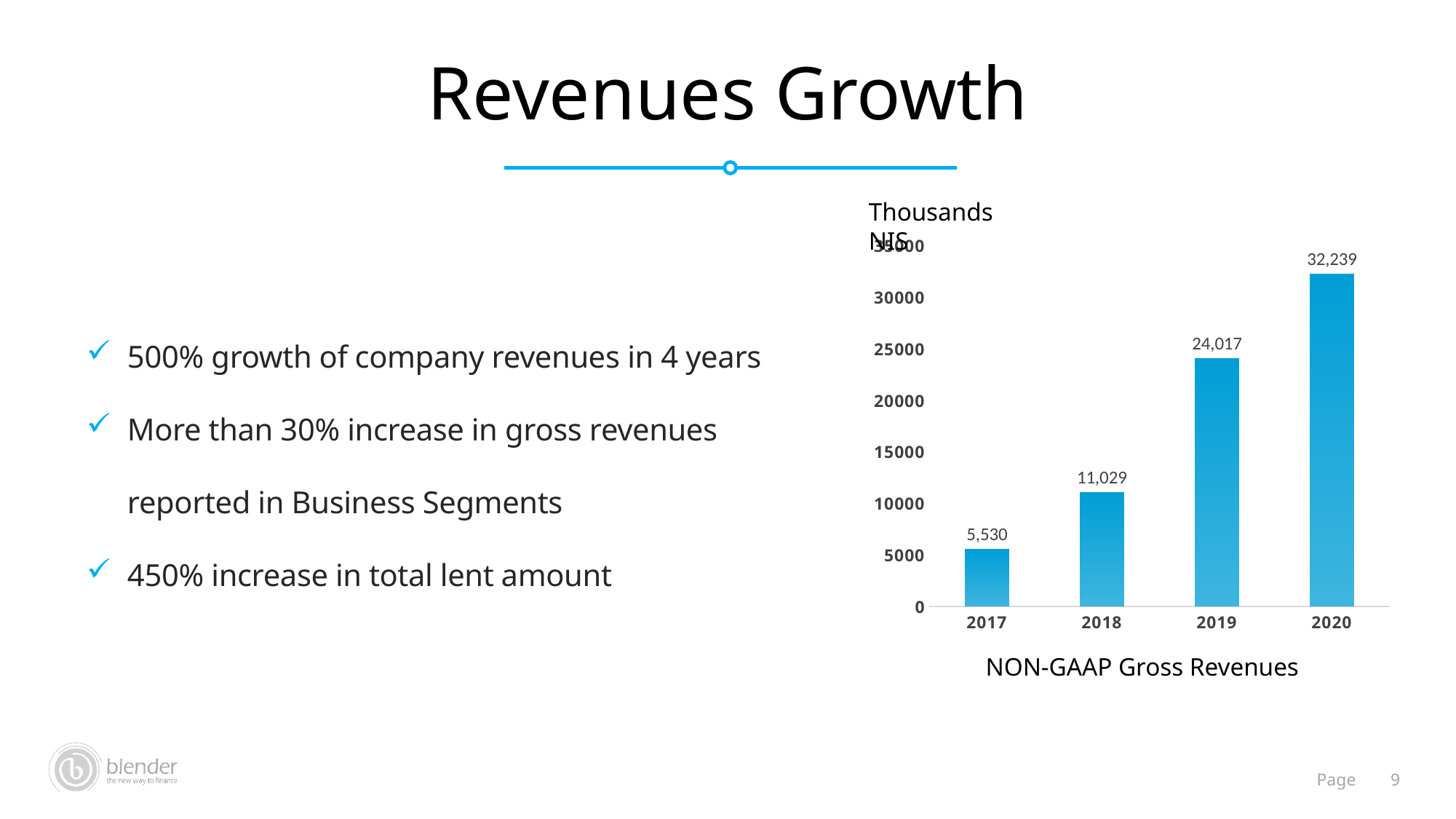
What unit is indicated above the chart's vertical axis? Thousands NIS What is the NON-GAAP Gross Revenues value for 2017? 5,530 What is the difference between the 2020 and 2019 NON-GAAP Gross Revenues values? 8,222 What is the NON-GAAP Gross Revenues value for 2020? 32,239 What is the NON-GAAP Gross Revenues value for 2018? 11,029 Which year has the highest NON-GAAP Gross Revenues? 2020 Which year has the lowest NON-GAAP Gross Revenues? 2017 What is the NON-GAAP Gross Revenues value for 2019? 24,017 Which year has the larger NON-GAAP Gross Revenues, 2018 or 2019? 2019 Do the NON-GAAP Gross Revenues values rise or fall from 2017 to 2020? Rise How many years are shown on the chart? 4 What kind of chart is shown on the slide? Bar chart